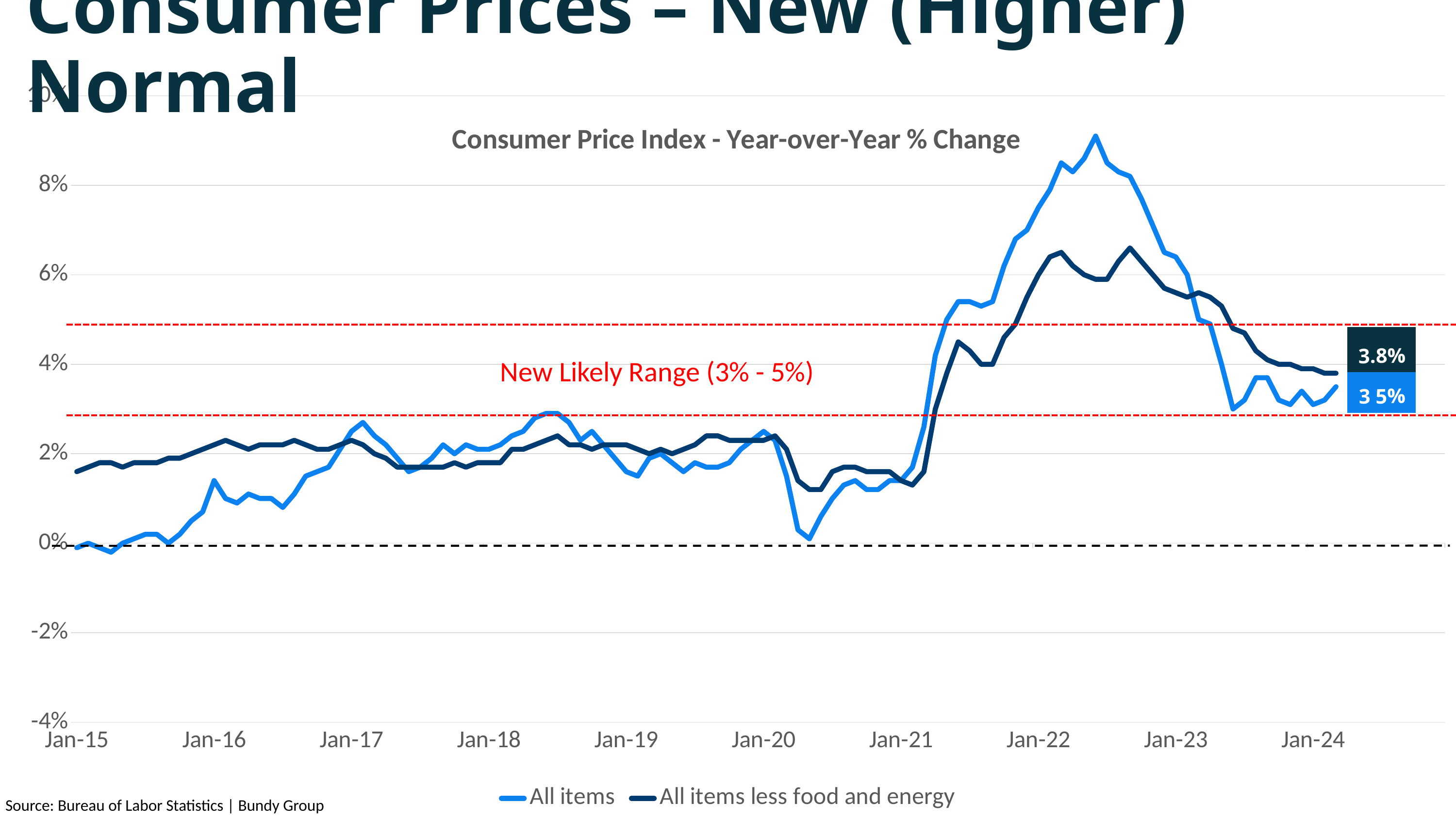
How many series does the legend list? 2 At the right end of the chart, which series has the higher value: 'All items' or 'All items less food and energy'? All items less food and energy Is the peak value of the 'All items' series greater or less than 8%? greater Does the 'All items' series rise or fall between Jan-22 and Jan-23? fall Is the peak value of the 'All items less food and energy' series greater or less than 6%? greater What is the difference between the latest labelled values of 'All items less food and energy' (3.8%) and 'All items' (3.5%)? 0.3% What is the title of the chart? Consumer Price Index - Year-over-Year % Change What kind of chart is shown on the slide? line chart What is the latest labelled value for the 'All items' series? 3.5% Which series reaches the higher peak around mid-2022? All items What is the latest labelled value for the 'All items less food and energy' series? 3.8% What range do the red dashed lines on the chart mark, according to the annotation? New Likely Range (3% - 5%)